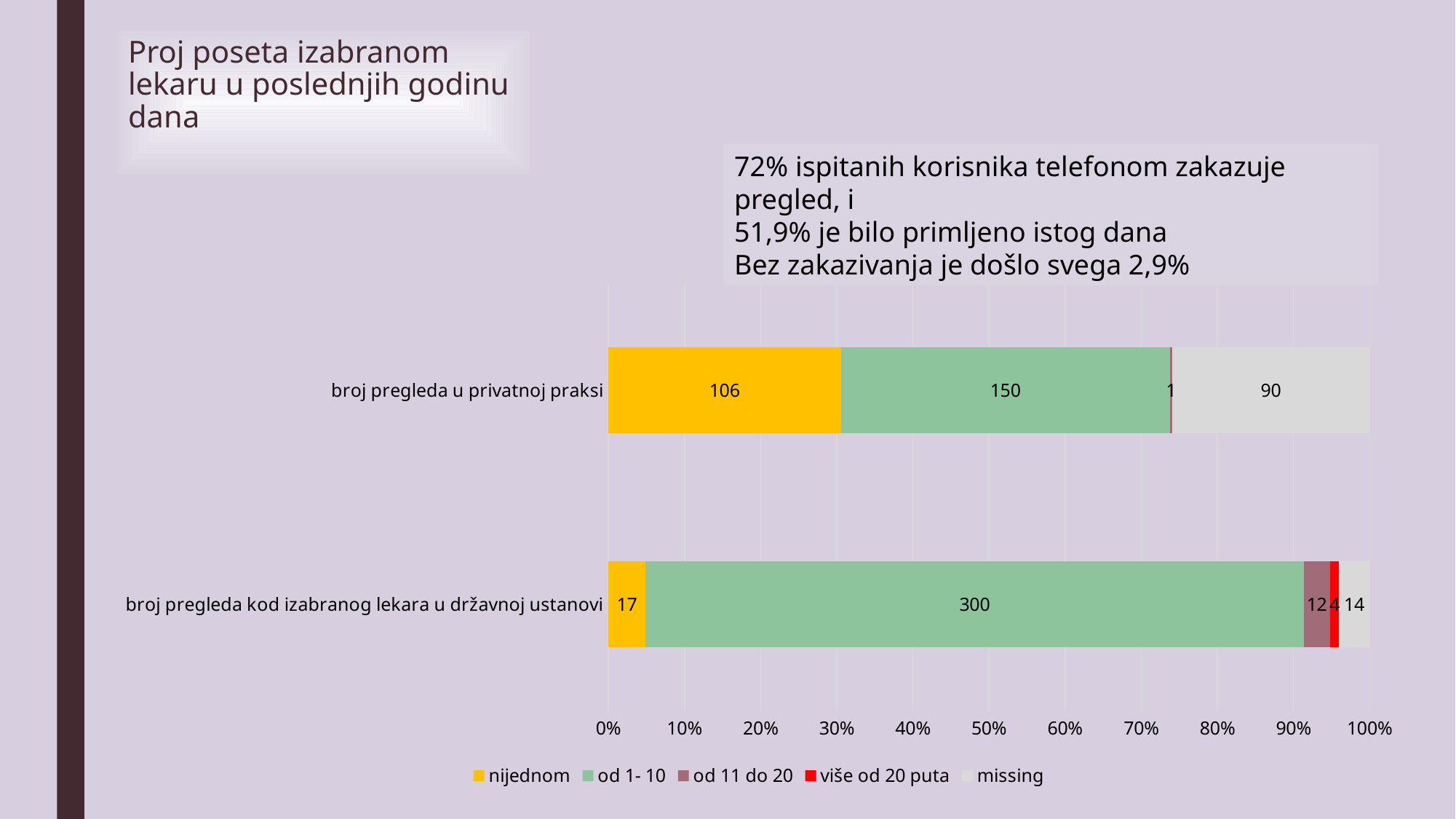
What is the difference between the 'od 1- 10' values for the two categories? 150 What kind of chart is shown on the slide? bar chart What is the total of all segments in the bar for 'broj pregleda kod izabranog lekara u državnoj ustanovi'? 347 What is the value of 'više od 20 puta' for 'broj pregleda kod izabranog lekara u državnoj ustanovi'? 4 What colour represents the 'nijednom' series in the legend? yellow What is the value of 'nijednom' for 'broj pregleda kod izabranog lekara u državnoj ustanovi'? 17 Which series has the largest value in the bar for 'broj pregleda kod izabranog lekara u državnoj ustanovi'? od 1- 10 How many series does the legend list? 5 How many categories (bars) are plotted in the chart? 2 What is the value of 'od 1- 10' for 'broj pregleda u privatnoj praksi'? 150 What is the value of 'missing' for 'broj pregleda u privatnoj praksi'? 90 Which category has the larger 'nijednom' value? broj pregleda u privatnoj praksi